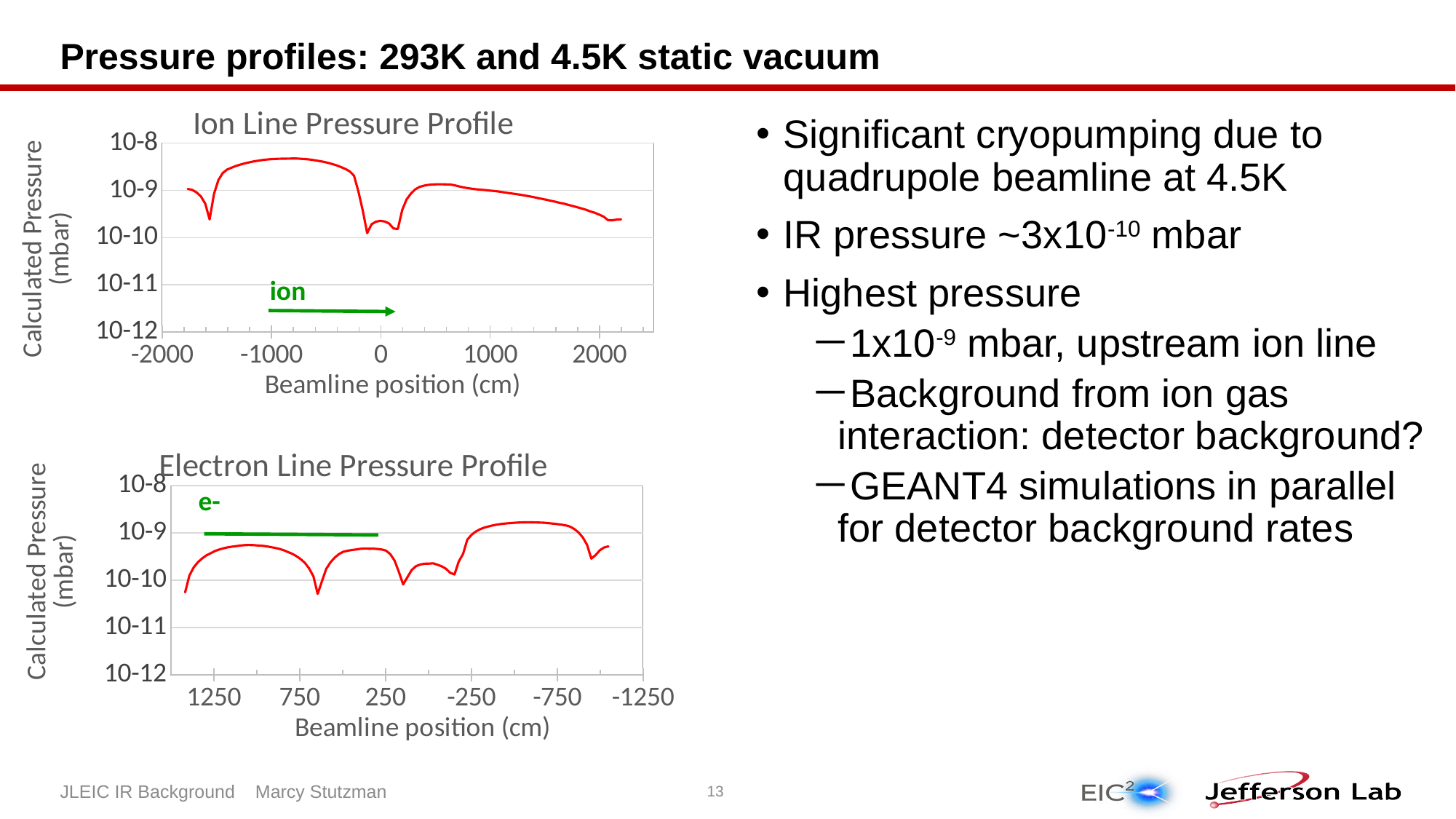
In the Ion Line Pressure Profile chart, which beamline position has the higher calculated pressure, -1000 cm or 0 cm? -1000 cm What kind of chart is the Ion Line Pressure Profile? line chart In the Electron Line Pressure Profile chart, is the calculated pressure at beamline position -500 cm greater or less than 10-9 mbar? greater In the Ion Line Pressure Profile chart, is the highest calculated pressure on the curve greater or less than 10-9 mbar? greater What is the x-axis label of the Ion Line Pressure Profile chart? Beamline position (cm) In the Ion Line Pressure Profile chart, is the calculated pressure at beamline position -1000 cm greater or less than 10-9 mbar? greater What is the title of the lower chart on the slide? Electron Line Pressure Profile How many charts are shown on the slide? 2 In the Electron Line Pressure Profile chart, which beamline position has the higher calculated pressure, -500 cm or 750 cm? -500 cm